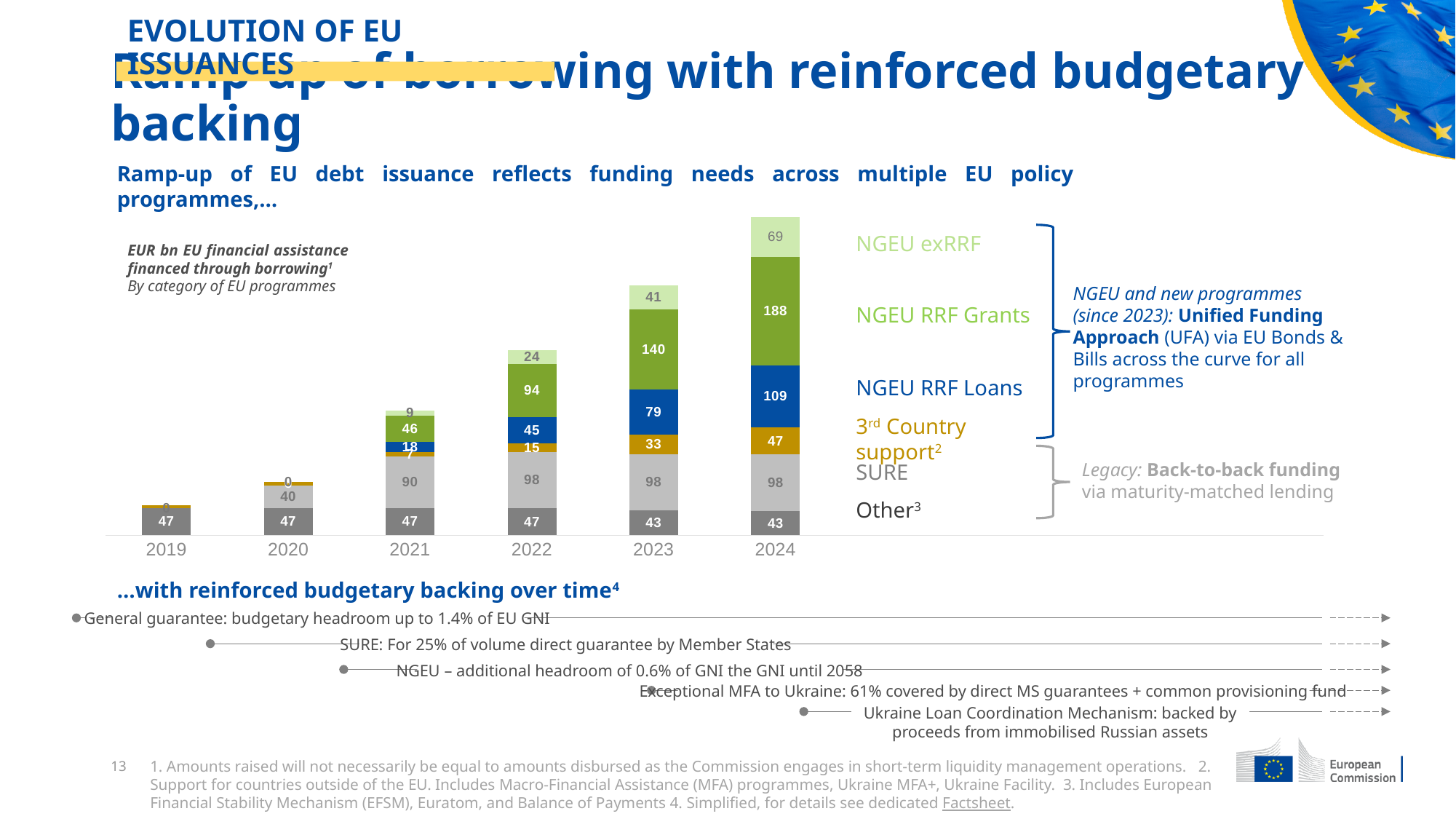
What is the value for NGEU RRF Loans in 2023? 79 Which is larger in 2022: NGEU RRF Grants or NGEU RRF Loans? NGEU RRF Grants What is the value for NGEU RRF Grants in 2024? 188 What type of chart is shown on the slide? Stacked bar chart Do the total stacked bar values rise or fall from 2019 to 2024? Rise How many years are shown on the x axis of the chart? 6 What is the total of the stacked bar for 2024? 554 What is the difference between NGEU RRF Grants in 2024 and in 2023? 48 In which year is the total stacked bar the highest? 2024 What is the value for 3rd Country support in 2022? 15 What is the value for SURE in 2021? 90 How many categories of EU programmes does the chart legend list? 6